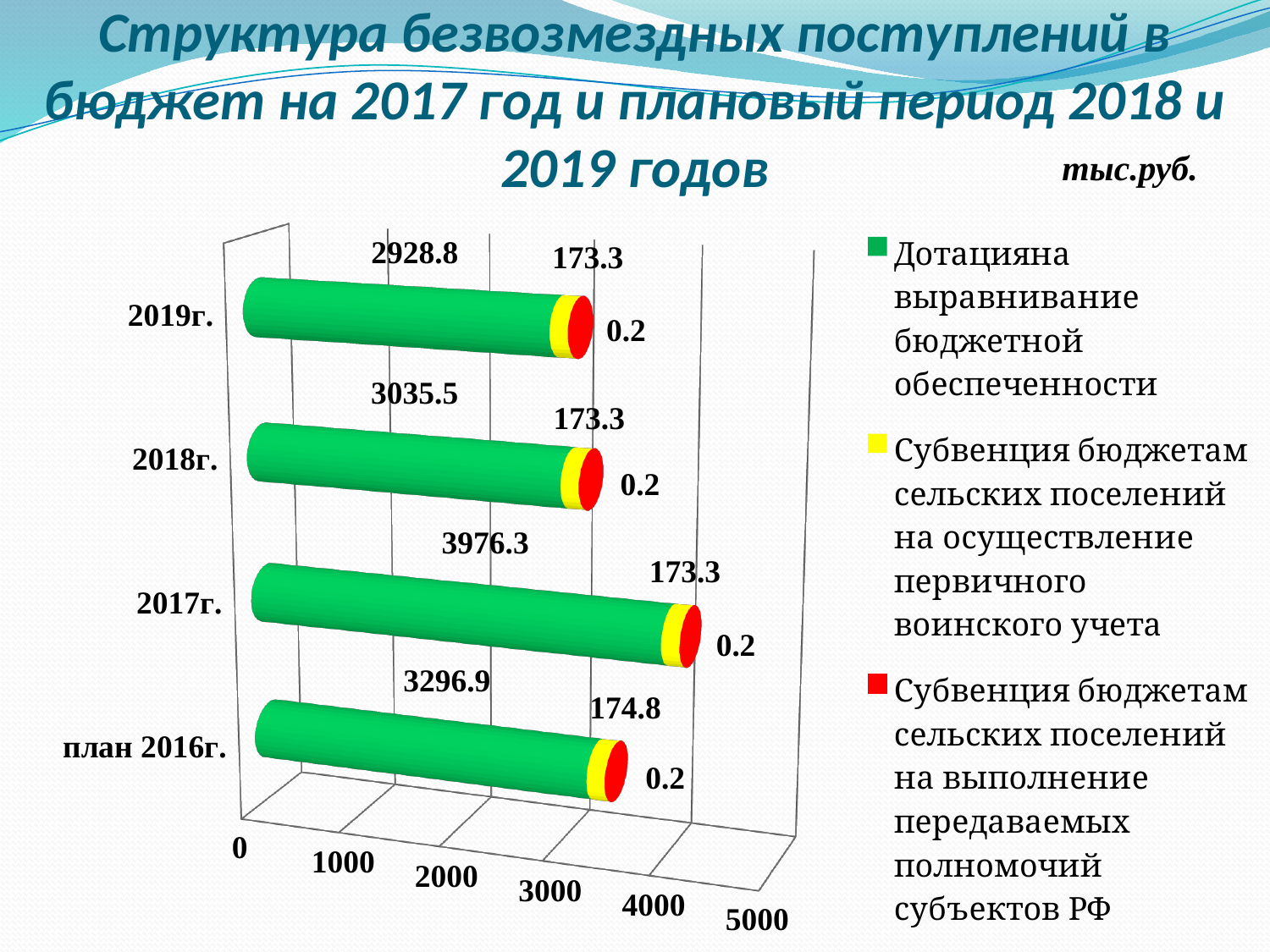
How many year categories are shown on the chart? 4 Which year has the lowest value of Дотация на выравнивание бюджетной обеспеченности? 2019г. What is the difference between the Дотация на выравнивание бюджетной обеспеченности values for 2017г. and 2018г.? 940.8 What is the value of Субвенция бюджетам сельских поселений на выполнение передаваемых полномочий субъектов РФ for 2018г.? 0.2 Which year has the highest value of Дотация на выравнивание бюджетной обеспеченности? 2017г. What is the total of the stacked bar for 2017г.? 4149.8 Which is larger, the Дотация на выравнивание бюджетной обеспеченности value for план 2016г. or for 2018г.? план 2016г. What is the value of Дотация на выравнивание бюджетной обеспеченности for 2019г.? 2928.8 What is the value of Субвенция бюджетам сельских поселений на осуществление первичного воинского учета for план 2016г.? 174.8 What kind of chart is shown on the slide? Stacked bar chart What is the value of Дотация на выравнивание бюджетной обеспеченности for 2017г.? 3976.3 How many series does the legend list? 3